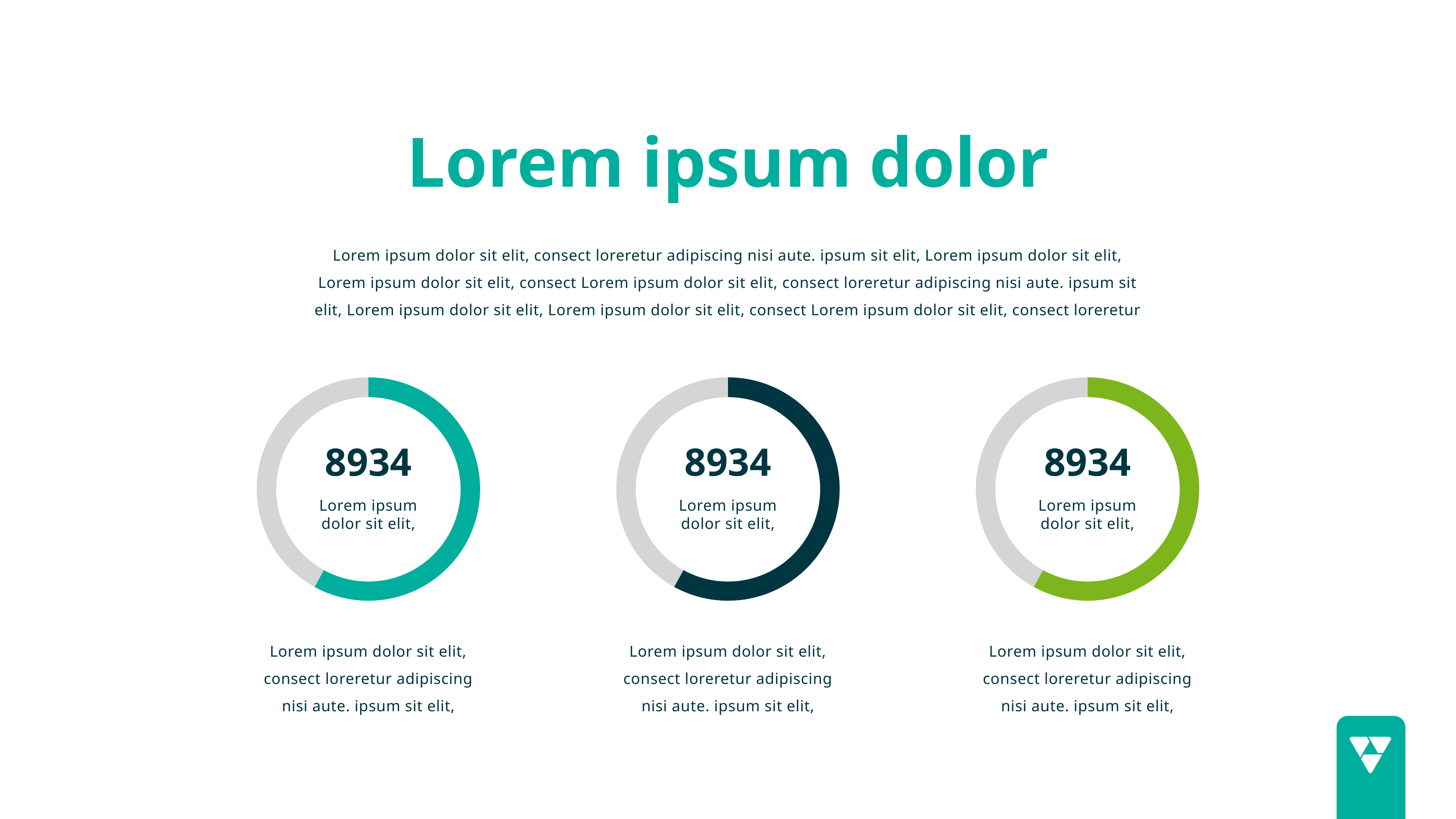
What colour is the filled segment of the left donut chart? Teal What kind of chart is shown in the left chart on the slide? Donut chart How many donut charts are on the slide? 3 What colour is the filled segment of the right donut chart? Green What number is printed in the centre of the left donut chart? 8934 What is the title of the slide containing the three donut charts? Lorem ipsum dolor What number is printed in the centre of the middle donut chart? 8934 What number is printed in the centre of the right donut chart? 8934